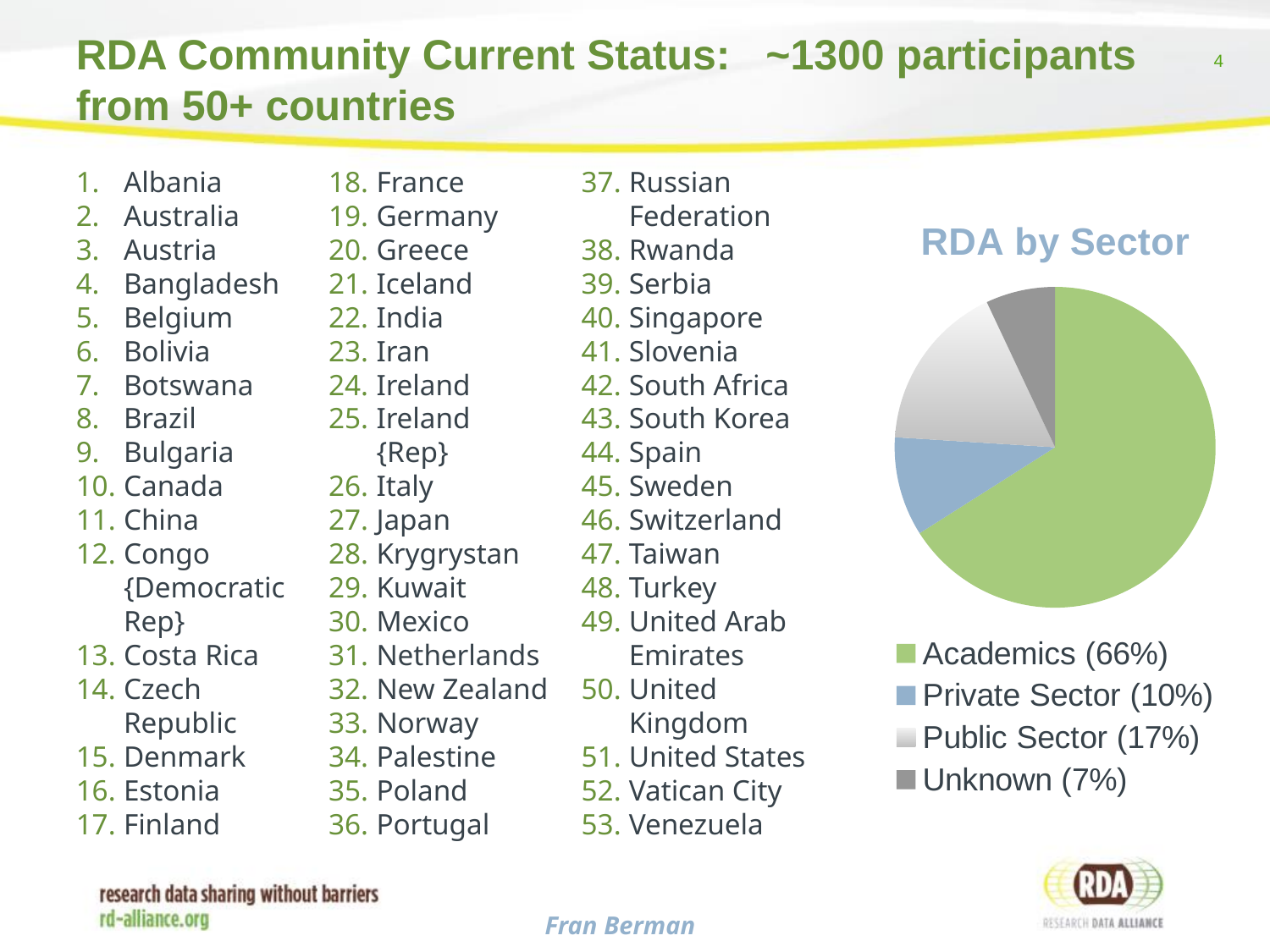
What share of the pie does Unknown represent? 7% What share of the pie does Private Sector represent? 10% Which colour represents Academics in the pie chart? green What is the difference in percentage points between the Academics share and the Public Sector share? 49 Which sector has the largest share of the pie? Academics What share of the pie does Academics represent? 66% Which sector has the smallest share of the pie? Unknown Which is larger, the share for Public Sector or the share for Private Sector? Public Sector How many sectors does the pie chart legend list? 4 What kind of chart is shown on the slide? pie chart What is the title of the chart? RDA by Sector